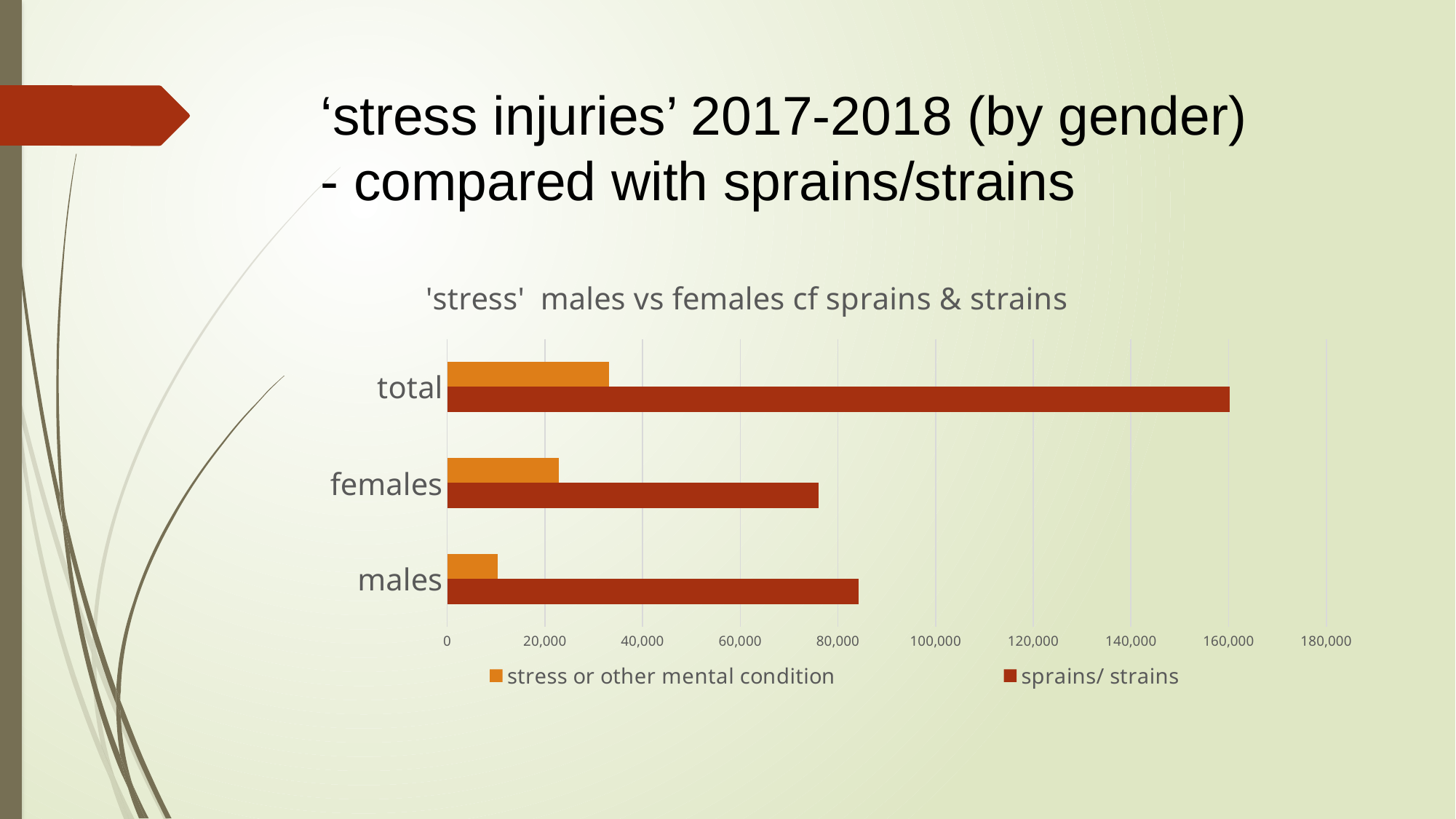
What is the title of the chart? 'stress' males vs females cf sprains & strains Is the sprains/ strains value for males greater or less than 80,000? greater Is the stress or other mental condition value for males greater or less than 20,000? less Is the sprains/ strains value for females greater or less than 80,000? less What kind of chart is shown on the slide? bar chart How many series does the legend list? 2 Which is larger for stress or other mental condition: males or females? females Which category has the lowest value for stress or other mental condition? males How many categories are shown on the chart? 3 Which category has the highest value for sprains/ strains? total Which is larger for sprains/ strains: males or females? males